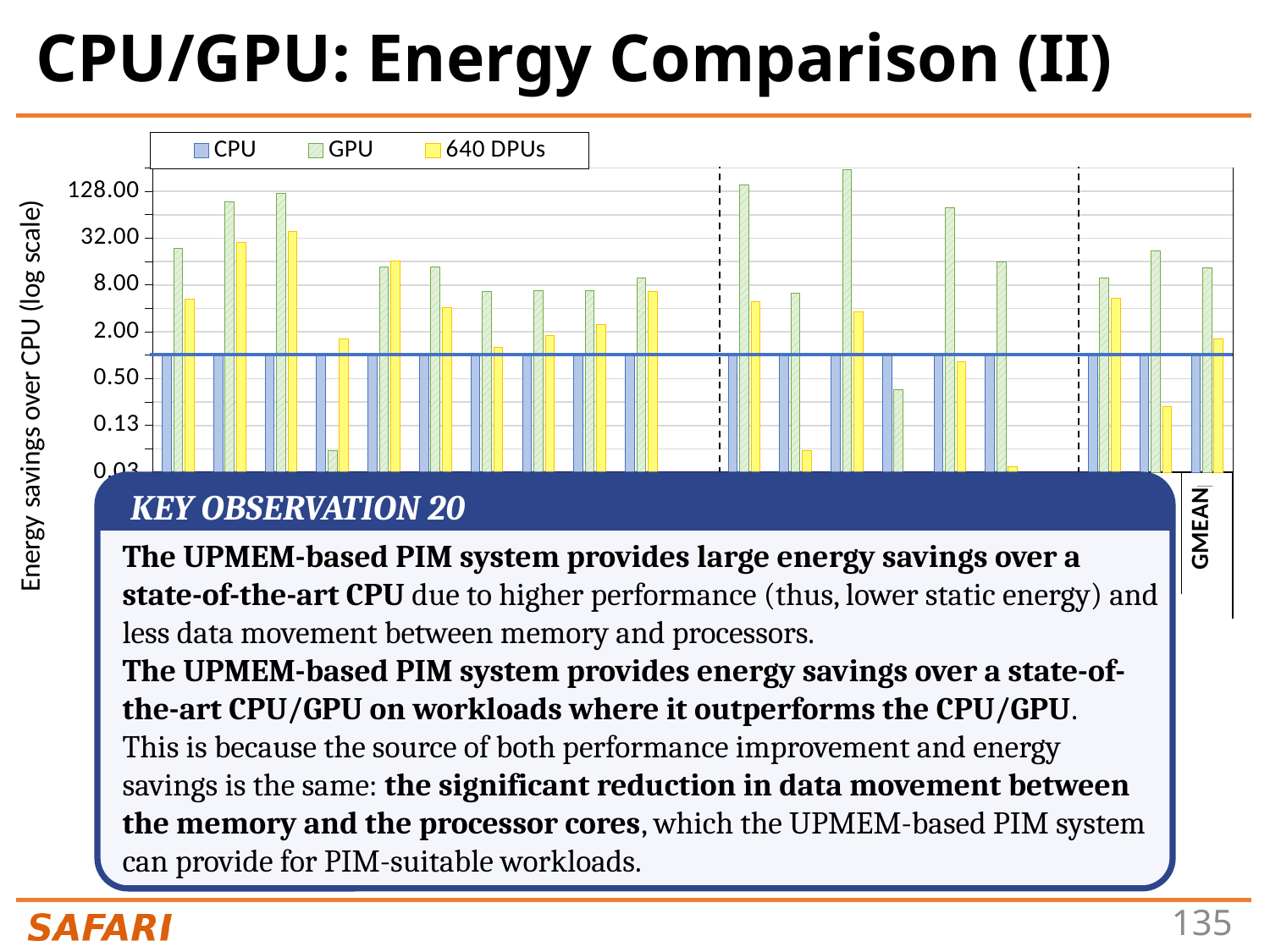
For the GMEAN category, which series has the highest bar? GPU What is the label of the chart's vertical axis? Energy savings over CPU (log scale) Is the GPU value for GMEAN greater or less than 32.00? less Is the 640 DPUs value for GMEAN greater or less than 0.50? greater Is the CPU value for GMEAN greater or less than 2.00? less How many series does the chart's legend list? 3 For the GMEAN category, which series has the lowest bar? CPU What are the three series named in the chart's legend? CPU, GPU, 640 DPUs What kind of chart is shown on the slide? bar chart For the GMEAN category, which is larger: the GPU value or the 640 DPUs value? GPU